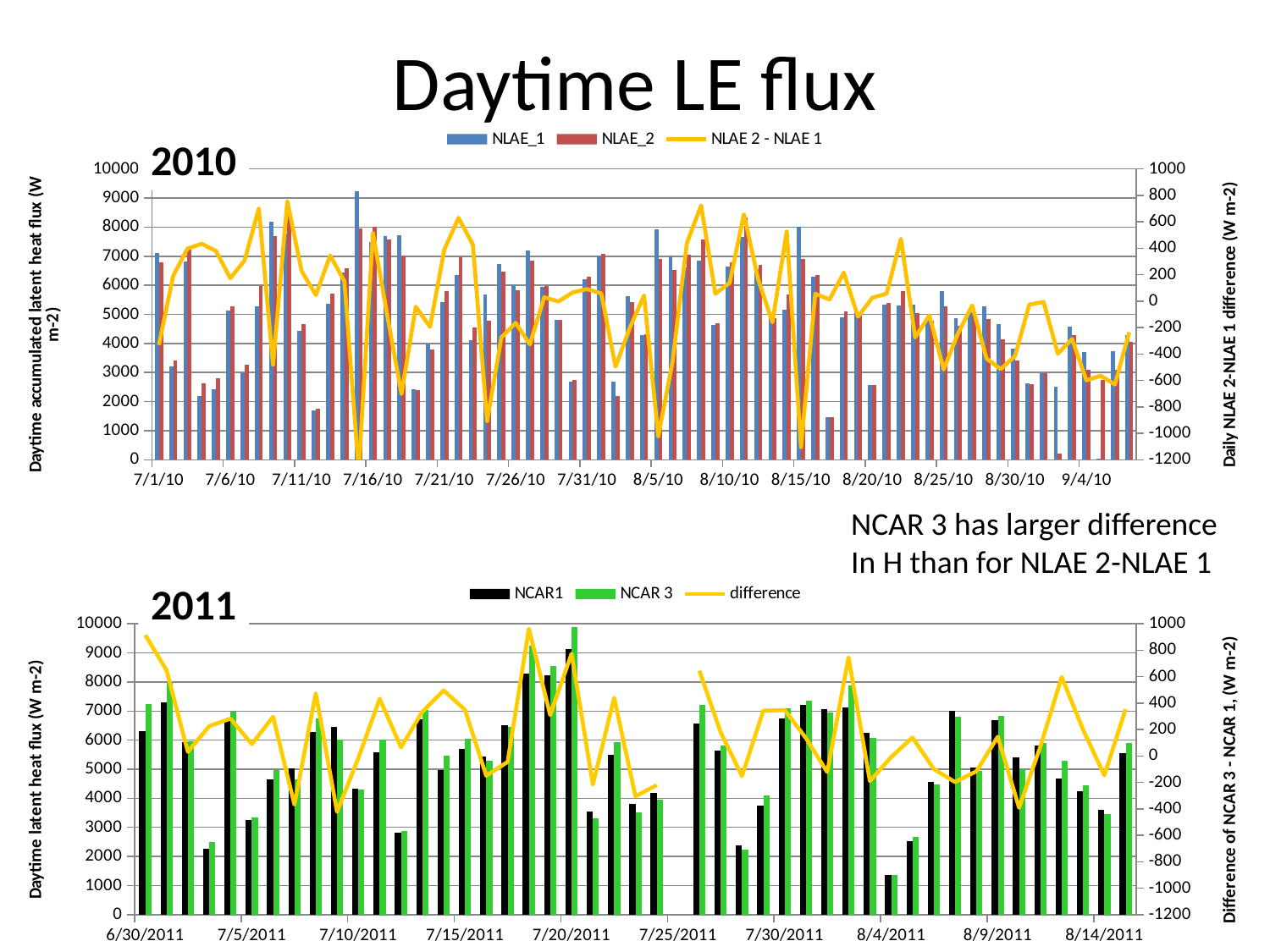
What are the legend entries of the 2011 chart? NCAR1, NCAR 3, difference In the 2010 chart, is the NLAE_1 value on 7/1/10 greater or less than 6000? greater What is the first date label on the x axis of the 2011 chart? 6/30/2011 What kind of chart is the 2011 chart? Bar chart with a line series In the 2010 chart, is the tallest NLAE_1 bar greater or less than 8000? greater How many series does the legend of the 2011 chart list? 3 What is the minimum value shown on the right vertical axis of the 2011 chart? -1200 What is the maximum value shown on the left vertical axis of the 2010 chart? 10000 How many series does the legend of the 2010 chart list? 3 In the 2011 chart, is the NCAR 3 value on 6/30/2011 greater or less than 6000? greater What are the legend entries of the 2010 chart? NLAE_1, NLAE_2, NLAE 2 - NLAE 1